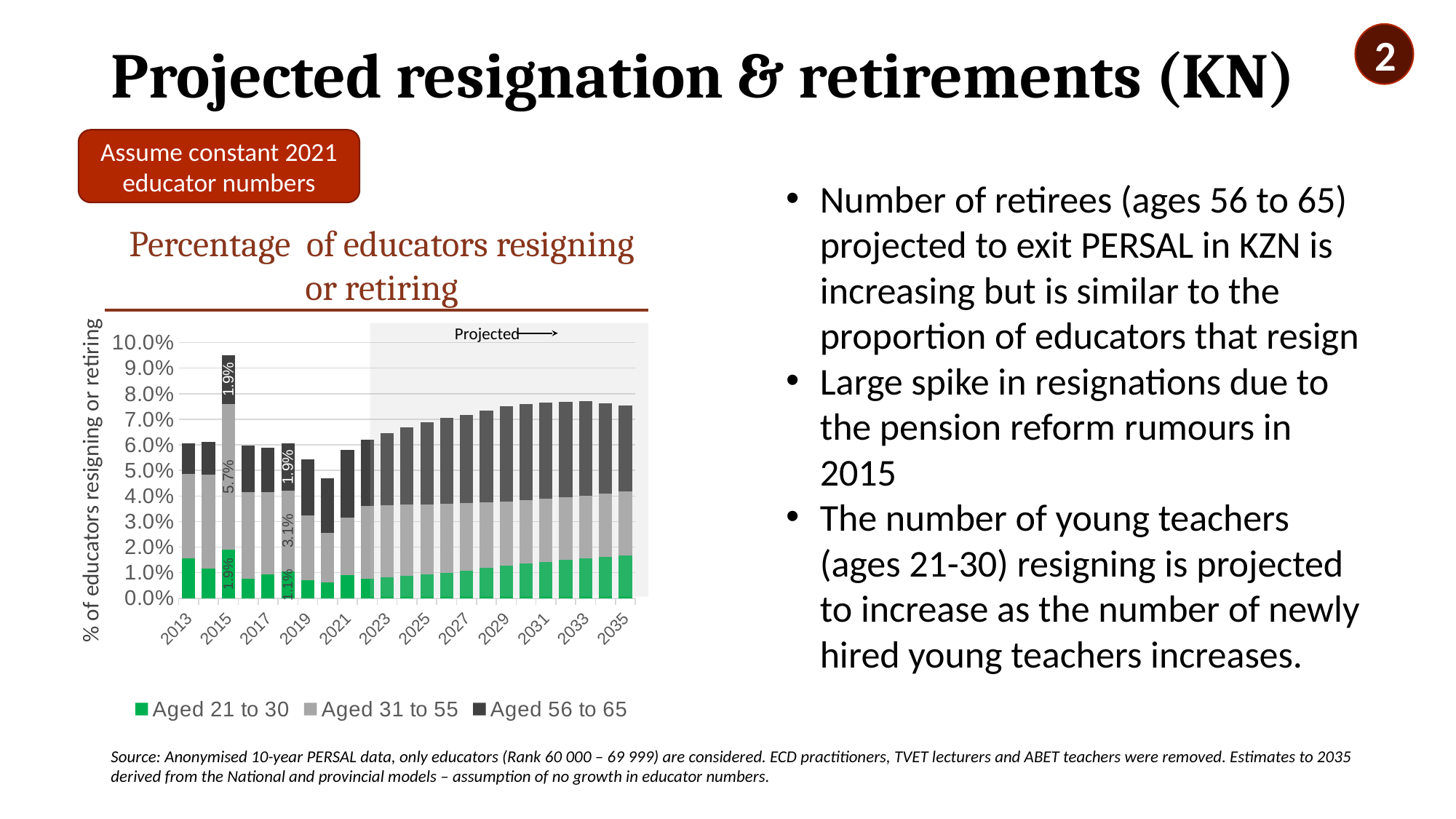
What is the total of the stacked bar for 2015? 9.5% What is the value for Aged 21 to 30 in 2015? 1.9% How many years (bars) are plotted in the chart? 23 What is the total of the stacked bar for 2018? 6.1% What is the difference between the Aged 31 to 55 and Aged 21 to 30 values in 2015? 3.8% What is the value for Aged 31 to 55 in 2015? 5.7% What is the value for Aged 21 to 30 in 2018? 1.1% What is the value for Aged 31 to 55 in 2018? 3.1% Which year has the highest total percentage of educators resigning or retiring? 2015 How many series does the legend list? 3 What kind of chart is shown on the slide? Stacked bar chart Is the total value for 2020 greater or less than 5.0%? less